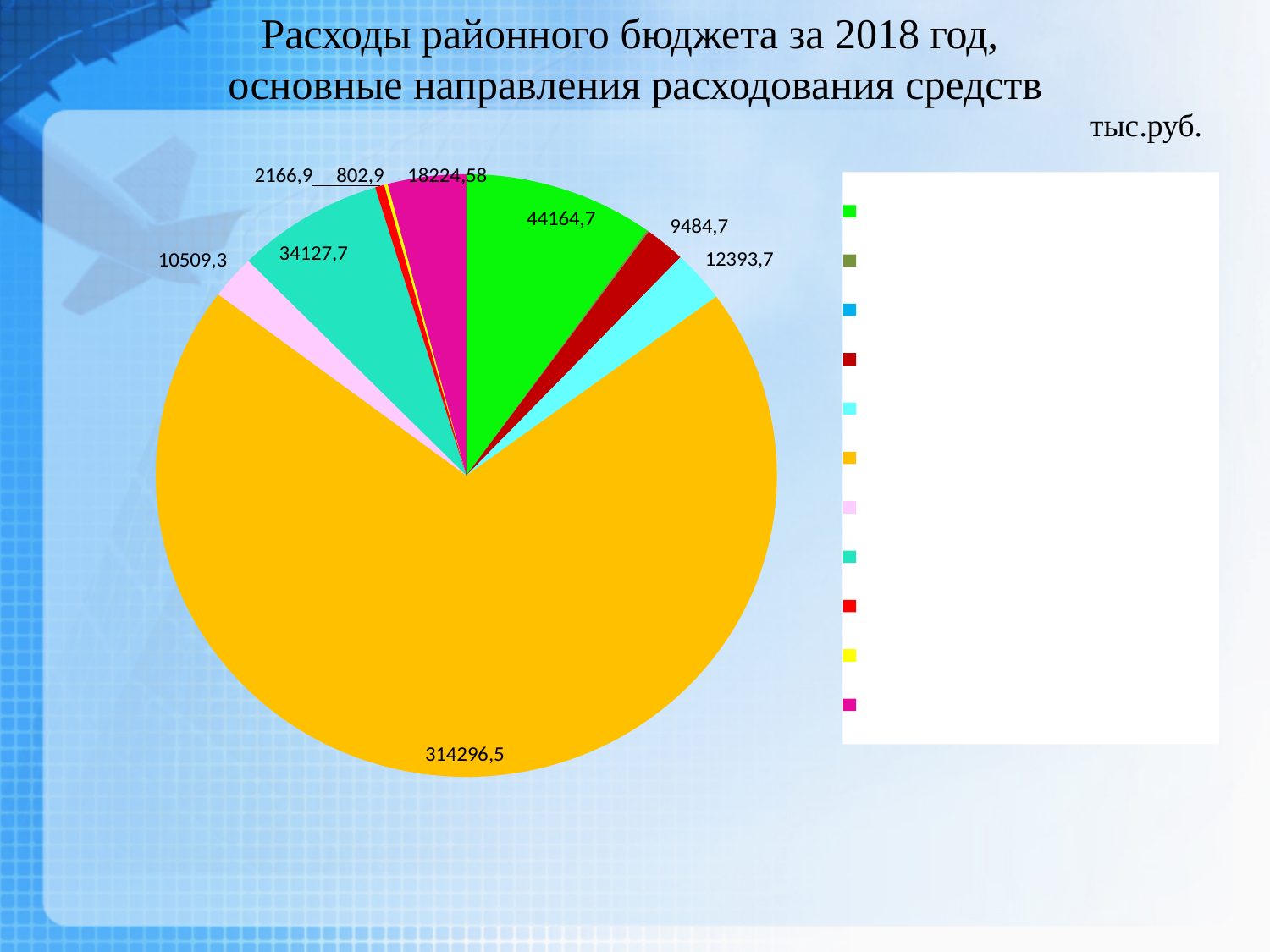
What value is labelled on the light pink slice of the pie? 10509,3 What value is labelled on the green slice of the pie? 44164,7 Which year's district budget expenditures does the chart title refer to? 2018 What is the difference between the green slice (44164,7) and the teal slice (34127,7)? 10037 What kind of chart is shown on the slide? pie chart What is the value of the largest (orange) slice of the pie? 314296,5 What value is labelled on the magenta slice of the pie? 18224,58 How many colour entries does the legend list? 11 What is the smallest labelled value on the pie chart? 802,9 What value is labelled on the teal (turquoise) slice of the pie? 34127,7 In what units are the values on the chart given, according to the slide? тыс.руб. Which slice is larger: the dark red slice labelled 9484,7 or the light cyan slice labelled 12393,7? the light cyan slice (12393,7)